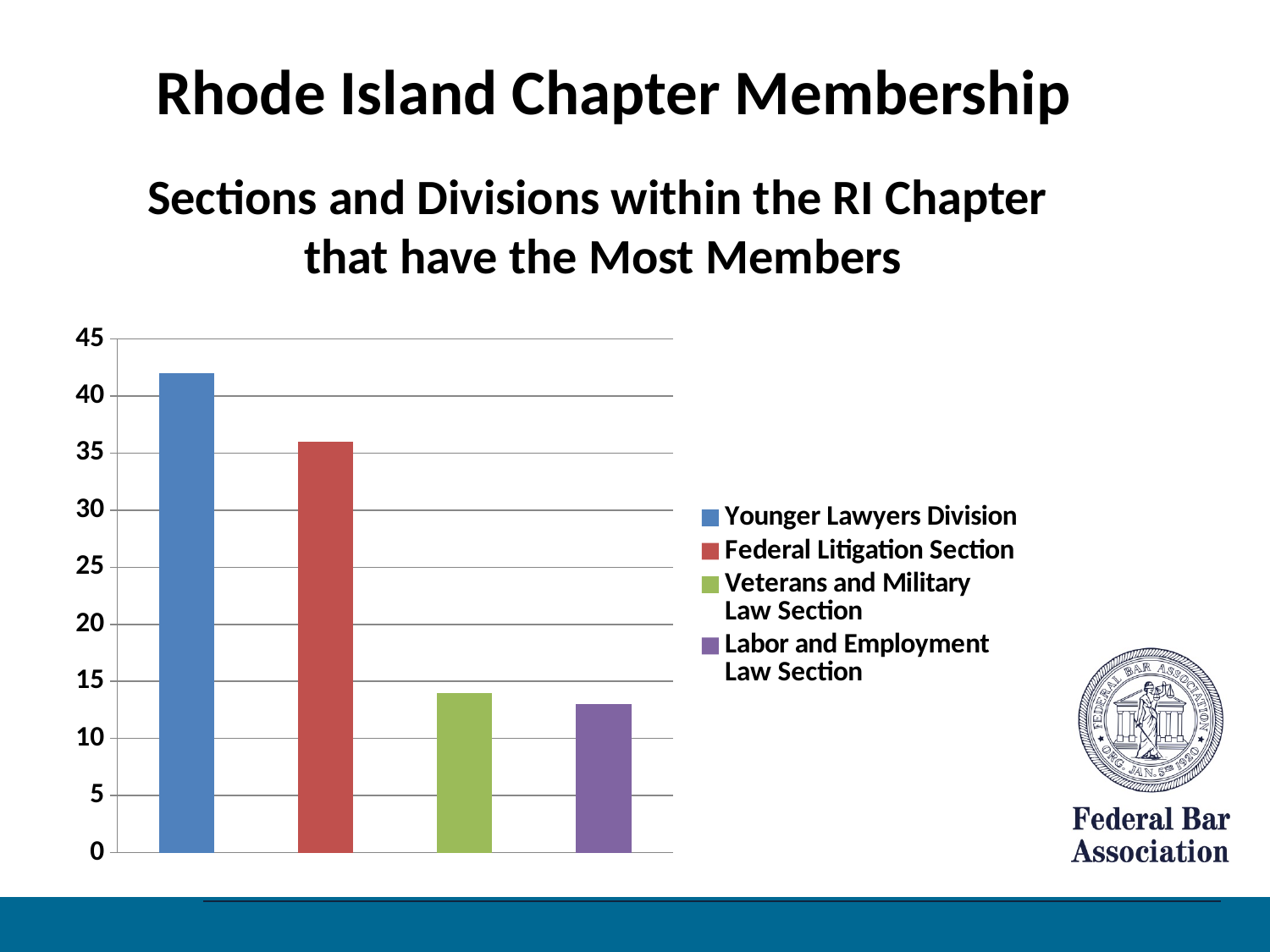
Which is larger, the value for Federal Litigation Section or the value for Veterans and Military Law Section? Federal Litigation Section What colour is the bar for Federal Litigation Section? red Is the value for Labor and Employment Law Section greater or less than 15? less Is the value for Younger Lawyers Division greater or less than 40? greater What kind of chart is shown on the slide? bar chart Which is larger, the value for Younger Lawyers Division or the value for Federal Litigation Section? Younger Lawyers Division How many entries does the chart legend list? 4 Which section or division has the highest membership in the chart? Younger Lawyers Division How many bars are plotted in the chart? 4 Is the value for Federal Litigation Section greater or less than 30? greater What is the subtitle above the chart? Sections and Divisions within the RI Chapter that have the Most Members